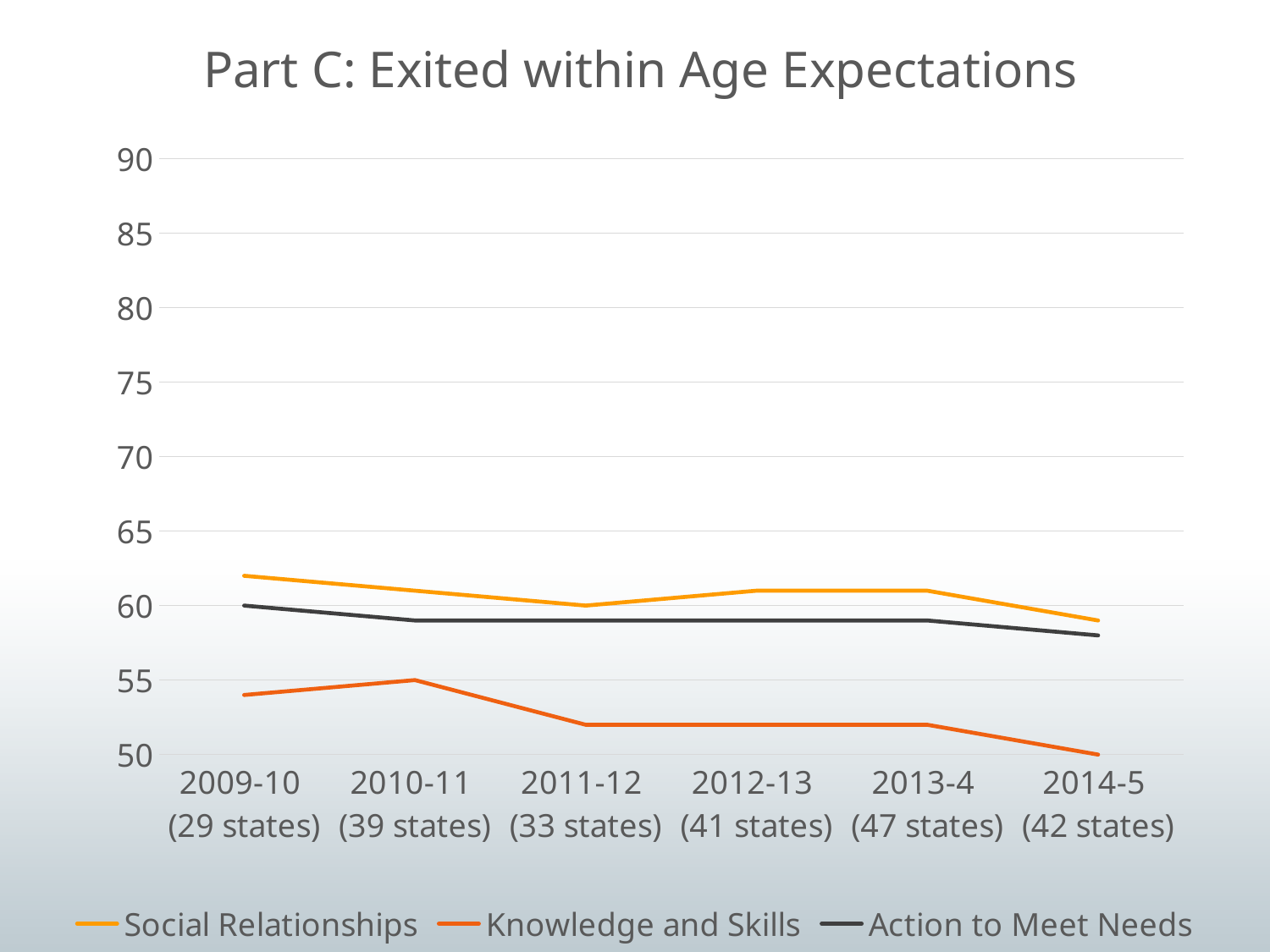
How many series does the legend list? 3 Is the value for Knowledge and Skills in 2011-12 greater or less than 55? less Does the Knowledge and Skills line overall rise or fall from 2009-10 to 2014-5? fall What kind of chart is shown on the slide? line chart What is the value for Knowledge and Skills in 2010-11? 55 How many time periods are plotted along the x axis? 6 Is the value for Action to Meet Needs in 2014-5 greater or less than 60? less In which period is Knowledge and Skills at its lowest? 2014-5 What is the value for Knowledge and Skills in 2014-5? 50 Is the value for Social Relationships in 2009-10 greater or less than 60? greater Which series is higher in 2012-13, Social Relationships or Knowledge and Skills? Social Relationships What is the value for Action to Meet Needs in 2009-10? 60